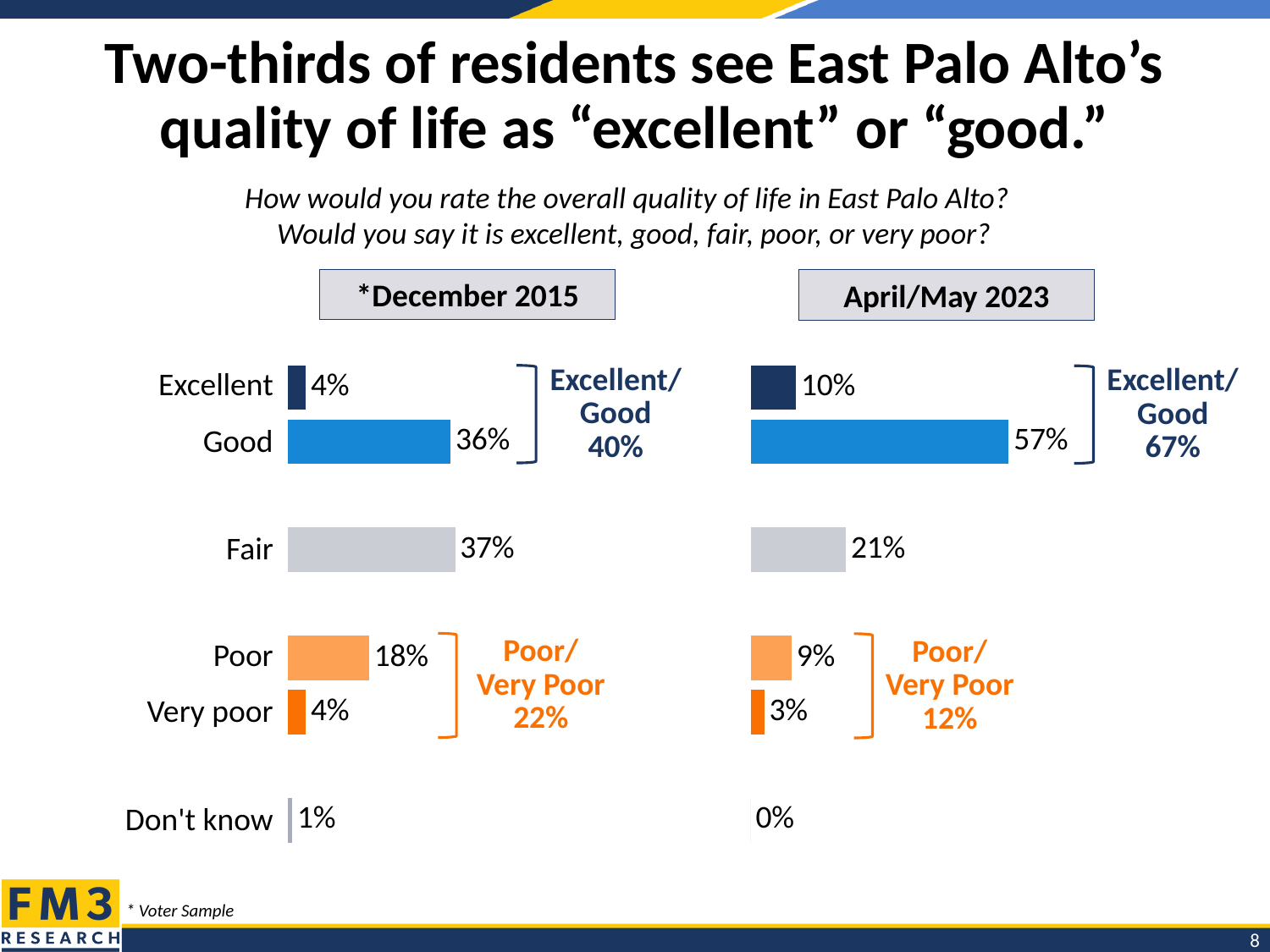
What type of chart is used on this slide? Bar chart What is the combined "Poor/Very Poor" percentage shown for December 2015? 22% In the April/May 2023 chart, which category has the highest value? Good In the December 2015 chart, which category has the highest value? Fair In the December 2015 chart, what percentage of residents rated quality of life as "Good"? 36% What is the difference between the "Good" values in the April/May 2023 chart and the December 2015 chart? 21% In the April/May 2023 chart, which category has the lowest value? Don't know How many response categories are shown in each chart? 6 In the December 2015 chart, which is larger: the value for "Poor" or the value for "Very poor"? Poor What is the combined "Excellent/Good" percentage shown for April/May 2023? 67% In the April/May 2023 chart, what percentage of residents rated quality of life as "Excellent"? 10% In the April/May 2023 chart, what is the value for "Fair"? 21%